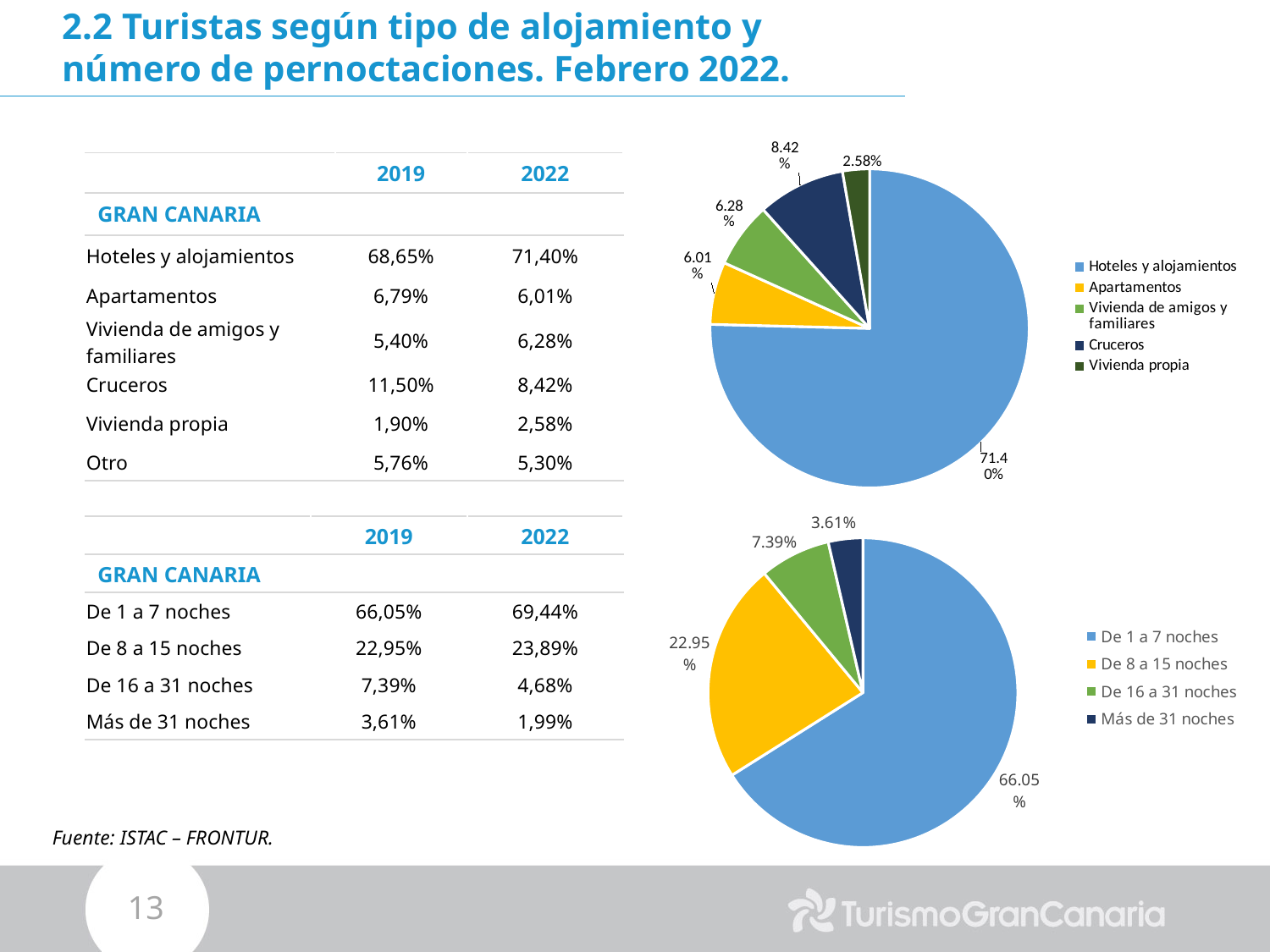
In the bottom pie chart, what is the value for De 8 a 15 noches? 22.95% In the top pie chart, what is the value for Cruceros? 8.42% In the bottom pie chart, what is the value for Más de 31 noches? 3.61% In the bottom pie chart, which category has the largest slice? De 1 a 7 noches What kind of chart is the top chart on the right of the slide? Pie chart In the bottom pie chart, what colour is the slice for De 16 a 31 noches? Green In the top pie chart, what is the difference between Cruceros and Vivienda de amigos y familiares? 2.14% In the top pie chart, what is the value for Vivienda propia? 2.58% In the top pie chart, which is larger, Apartamentos or Cruceros? Cruceros How many categories does the legend of the top pie chart list? 5 In the top pie chart, which category has the smallest slice? Vivienda propia In the top pie chart, what is the value for Hoteles y alojamientos? 71.40%